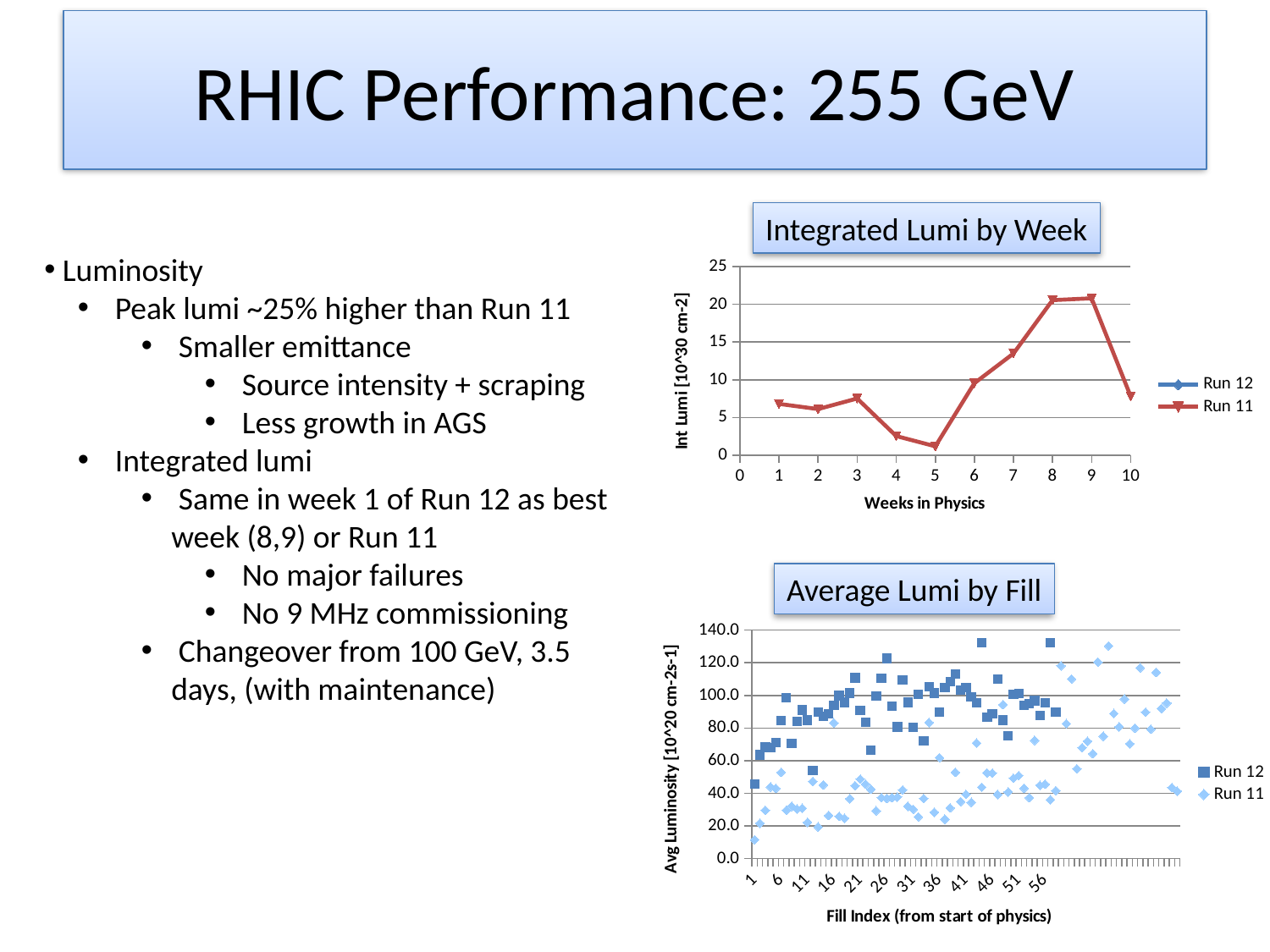
In the "Integrated Lumi by Week" chart, is the Run 11 value at week 9 greater or less than 15? greater What kind of chart is the "Integrated Lumi by Week" chart? line chart How many series does the legend of the "Average Lumi by Fill" chart list? 2 In the "Integrated Lumi by Week" chart, is the Run 11 value at week 7 greater or less than 10? greater In the "Integrated Lumi by Week" chart, do the Run 11 values rise or fall from week 5 to week 9? rise In the "Integrated Lumi by Week" chart, at which week is the Run 11 integrated luminosity lowest? 5 What is the x-axis title of the "Integrated Lumi by Week" chart? Weeks in Physics In the "Integrated Lumi by Week" chart, is the Run 11 value at week 8 larger or smaller than the value at week 10? larger What is the y-axis title of the "Average Lumi by Fill" chart? Avg Luminosity [10^20 cm-2s-1] In the "Integrated Lumi by Week" chart, is the Run 11 value at week 4 greater or less than 5? less How many series does the legend of the "Integrated Lumi by Week" chart list? 2 What kind of chart is the "Average Lumi by Fill" chart? scatter chart